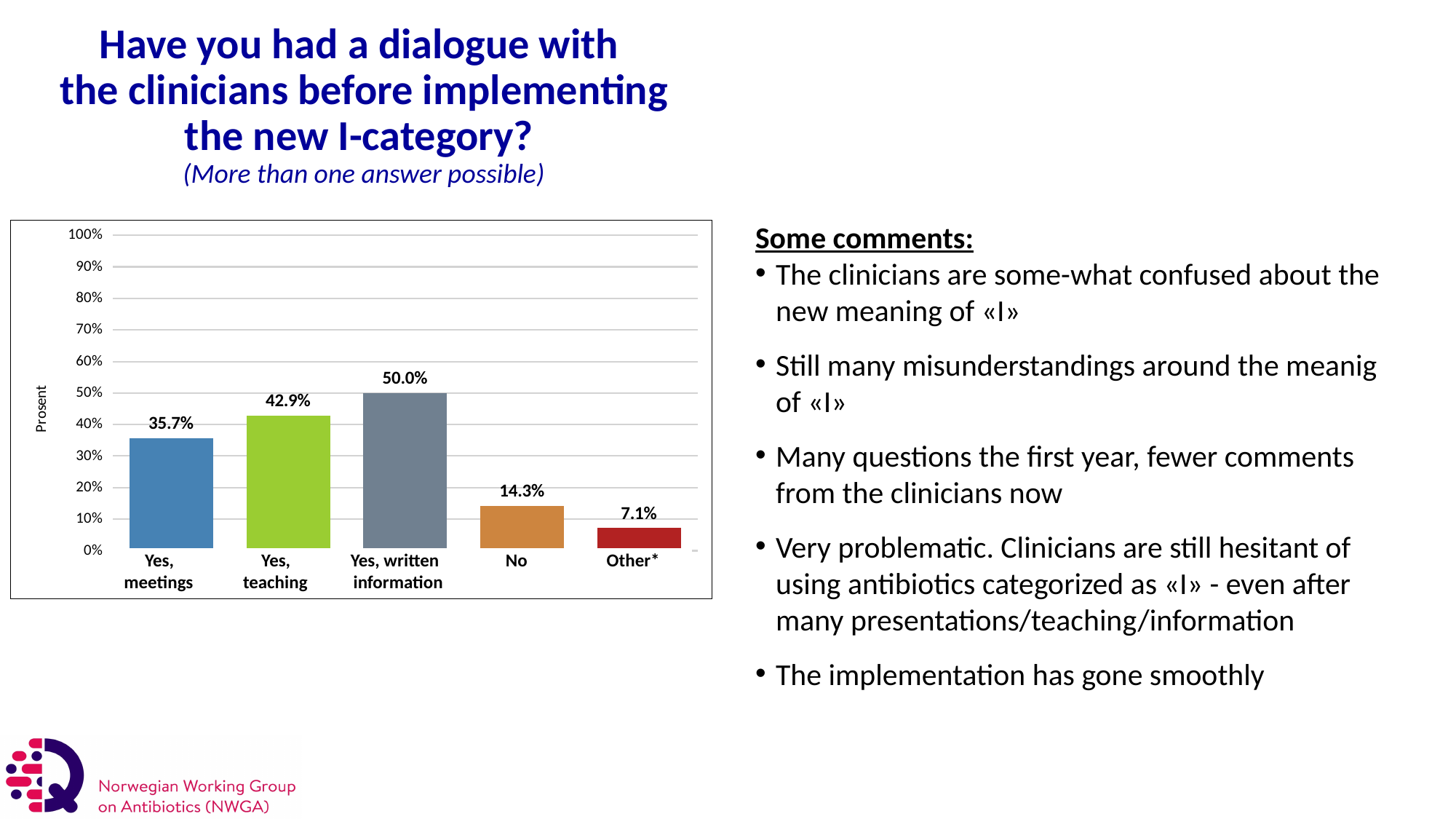
What is the label on the vertical axis of the chart? Prosent What is the value for "Yes, written information"? 50.0% What kind of chart is shown on the slide? bar chart Which category has the lowest value? Other* What is the value for "Yes, meetings"? 35.7% What is the value for "Yes, teaching"? 42.9% Which category has the highest value? Yes, written information Which is larger, the value for "Yes, teaching" or the value for "Yes, meetings"? Yes, teaching What is the difference between the values for "Yes, written information" and "No"? 35.7% What is the value for "No"? 14.3% How many categories are shown on the x axis? 5 Is the value for "Other*" greater or less than 10%? less